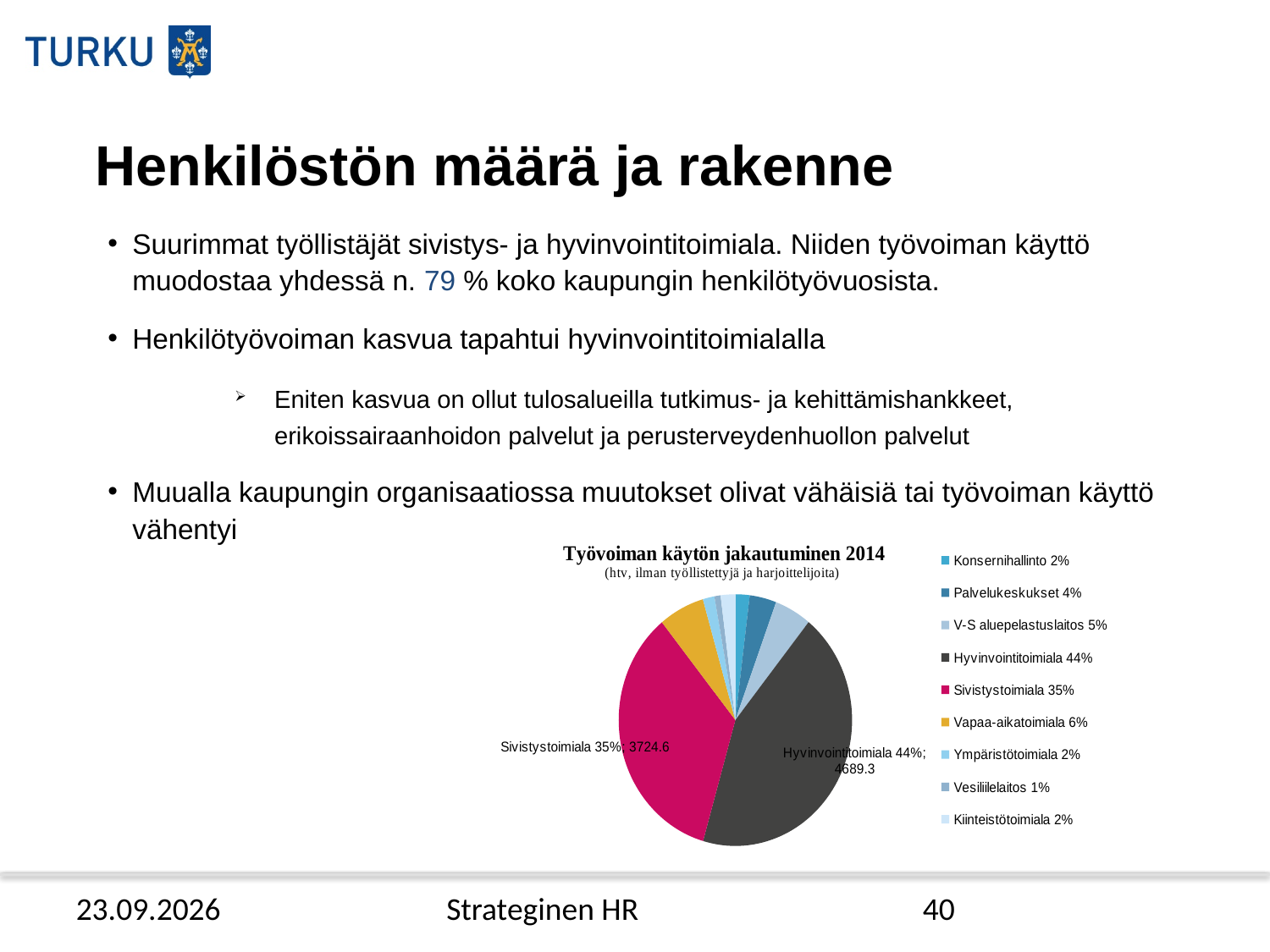
How many categories does the legend of the pie chart list? 9 Which is larger, the share for Vapaa-aikatoimiala or the share for V-S aluepelastuslaitos? Vapaa-aikatoimiala What share of the pie does Hyvinvointitoimiala represent? 44% What is the title of the chart on the slide? Työvoiman käytön jakautuminen 2014 What kind of chart is shown on the slide? pie chart What share of the pie does Sivistystoimiala represent? 35% What is the difference between the labelled values for Hyvinvointitoimiala and Sivistystoimiala? 964.7 What share of the pie does Palvelukeskukset represent? 4% Which category has the smallest share according to the legend? Vesiliilelaitos What value is printed on the data label for Sivistystoimiala? 3724.6 What value is printed on the data label for Hyvinvointitoimiala? 4689.3 Which category has the largest slice of the pie? Hyvinvointitoimiala